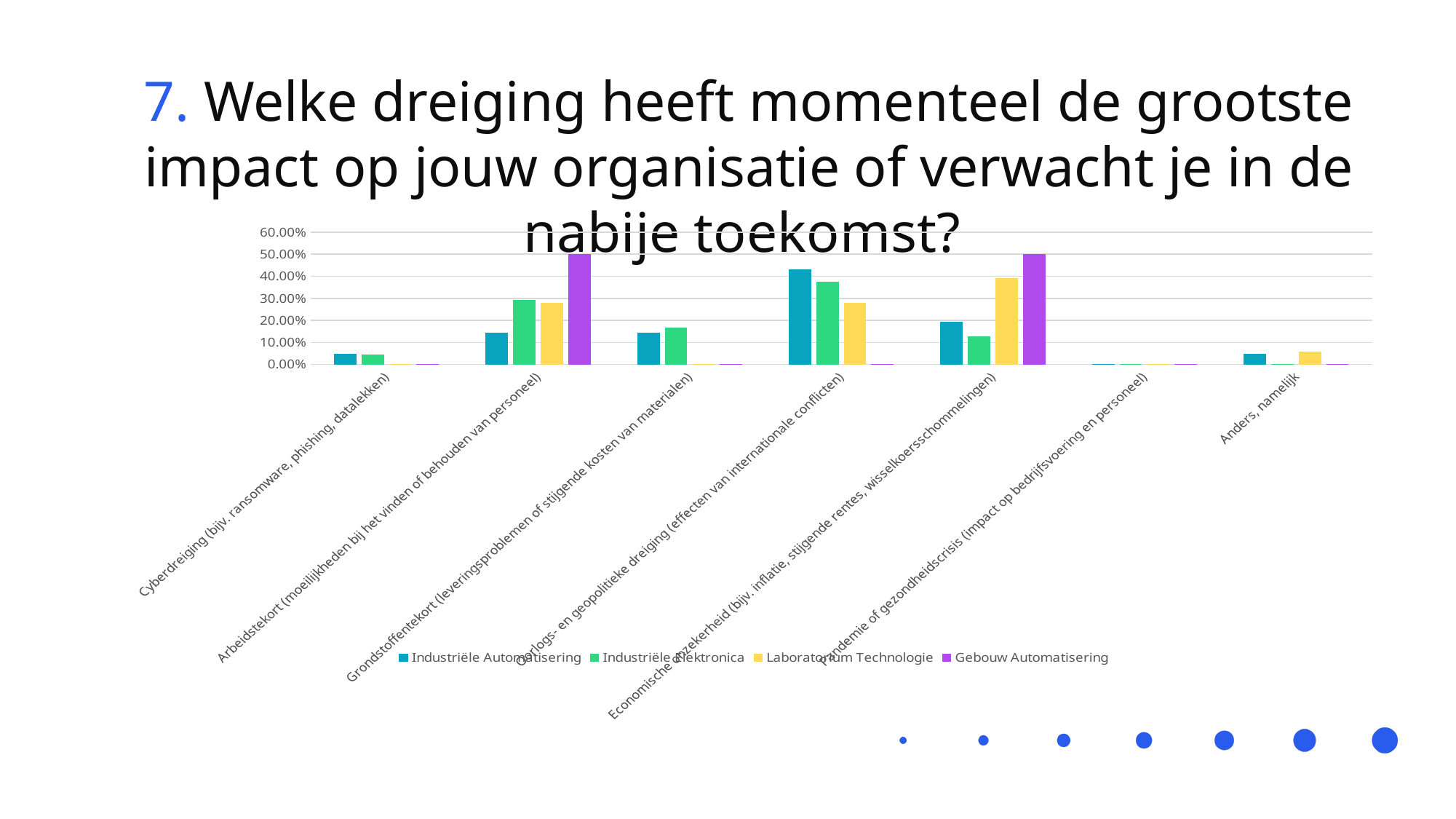
Which series has the highest value for 'Oorlogs- en geopolitieke dreiging (effecten van internationale conflicten)'? Industriële Automatisering Is the value for Industriële Automatisering in the 'Arbeidstekort' category greater or less than 10.00%? greater What is the value for Gebouw Automatisering in the 'Arbeidstekort' category? 50.00% What kind of chart is shown on the slide? bar chart In the 'Oorlogs- en geopolitieke dreiging' category, which is larger: Industriële Automatisering or Industriële Elektronica? Industriële Automatisering How many categories are shown along the x axis? 7 Is the value for Industriële Automatisering in the 'Oorlogs- en geopolitieke dreiging' category greater or less than 40.00%? greater Is the value for Industriële Elektronica in the 'Oorlogs- en geopolitieke dreiging' category greater or less than 40.00%? less How many series does the legend list? 4 Which colour represents Gebouw Automatisering in the legend? purple Which series has the highest value for 'Arbeidstekort (moeilijkheden bij het vinden of behouden van personeel)'? Gebouw Automatisering In the 'Economische onzekerheid' category, which is larger: Gebouw Automatisering or Industriële Elektronica? Gebouw Automatisering